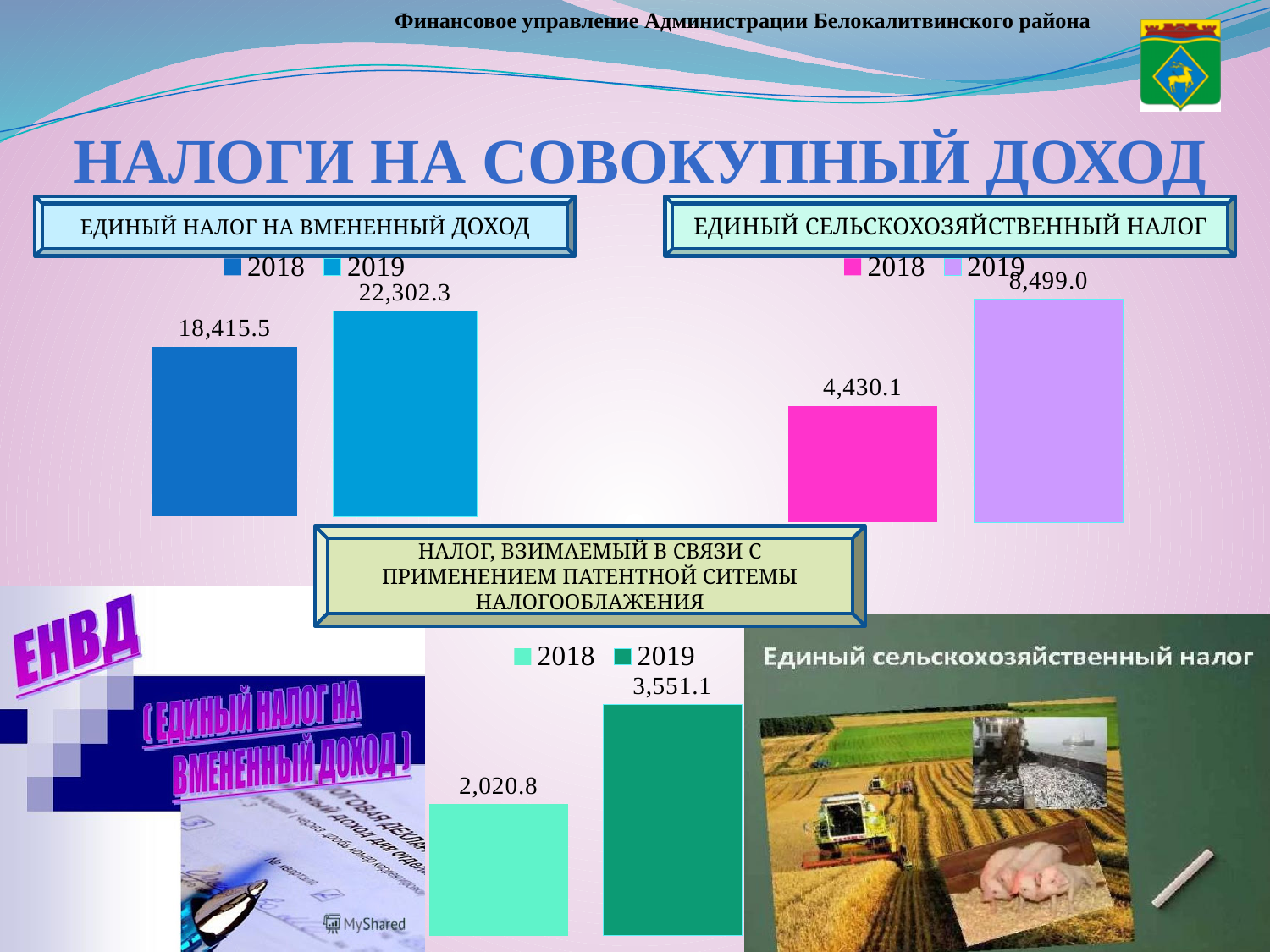
In the chart titled "ЕДИНЫЙ СЕЛЬСКОХОЗЯЙСТВЕННЫЙ НАЛОГ", what is the difference between the 2019 and 2018 values? 4,068.9 In the chart titled "ЕДИНЫЙ СЕЛЬСКОХОЗЯЙСТВЕННЫЙ НАЛОГ", which year has the lower value? 2018 In the chart titled "ЕДИНЫЙ НАЛОГ НА ВМЕНЕННЫЙ ДОХОД", what is the value for 2019? 22,302.3 In the chart titled "НАЛОГ, ВЗИМАЕМЫЙ В СВЯЗИ С ПРИМЕНЕНИЕМ ПАТЕНТНОЙ СИТЕМЫ НАЛОГООБЛАЖЕНИЯ", which year has the higher value? 2019 In the chart titled "НАЛОГ, ВЗИМАЕМЫЙ В СВЯЗИ С ПРИМЕНЕНИЕМ ПАТЕНТНОЙ СИТЕМЫ НАЛОГООБЛАЖЕНИЯ", what is the value for 2019? 3,551.1 In the chart titled "ЕДИНЫЙ СЕЛЬСКОХОЗЯЙСТВЕННЫЙ НАЛОГ", what is the value for 2019? 8,499.0 In the chart titled "НАЛОГ, ВЗИМАЕМЫЙ В СВЯЗИ С ПРИМЕНЕНИЕМ ПАТЕНТНОЙ СИТЕМЫ НАЛОГООБЛАЖЕНИЯ", what is the value for 2018? 2,020.8 In the chart titled "ЕДИНЫЙ НАЛОГ НА ВМЕНЕННЫЙ ДОХОД", what is the difference between the 2019 and 2018 values? 3,886.8 In the chart titled "ЕДИНЫЙ НАЛОГ НА ВМЕНЕННЫЙ ДОХОД", what is the value for 2018? 18,415.5 What kind of chart is the one titled "ЕДИНЫЙ НАЛОГ НА ВМЕНЕННЫЙ ДОХОД"? Bar chart How many series does the legend of the chart titled "ЕДИНЫЙ СЕЛЬСКОХОЗЯЙСТВЕННЫЙ НАЛОГ" list? 2 In the chart titled "ЕДИНЫЙ СЕЛЬСКОХОЗЯЙСТВЕННЫЙ НАЛОГ", what is the value for 2018? 4,430.1